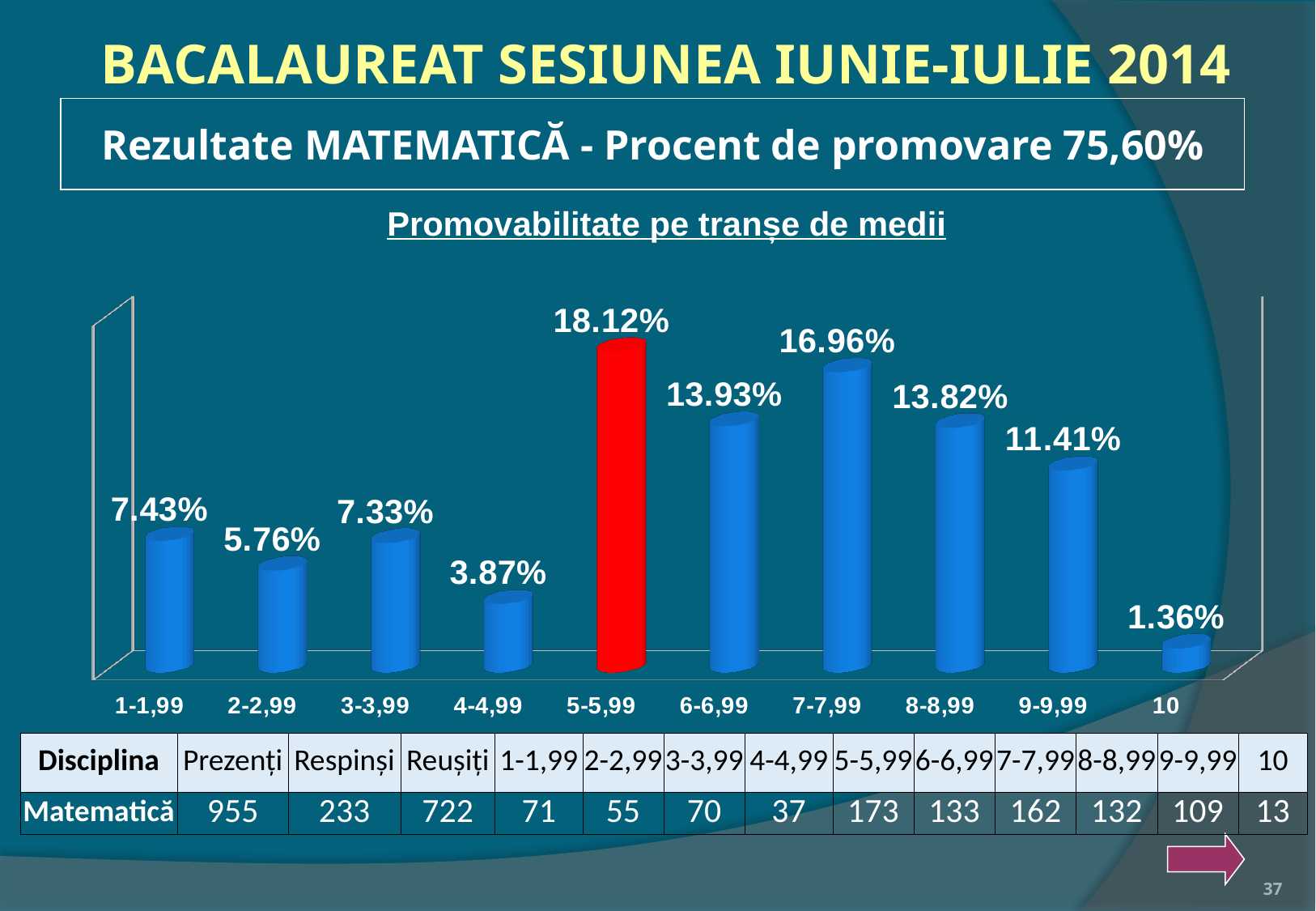
What is the difference between the values for 9-9,99 and 10? 10.05% What is the difference between the values for 5-5,99 and 7-7,99? 1.16% What is the value for the 5-5,99 category? 18.12% What is the value for the 10 category? 1.36% Which is larger, the value for 2-2,99 or the value for 9-9,99? 9-9,99 What is the value for the 7-7,99 category? 16.96% What is the value for the 4-4,99 category? 3.87% Which category has the lowest value? 10 How many categories are shown on the x axis of the chart? 10 What type of chart is shown on the slide? bar chart What is the title of the chart? Promovabilitate pe tranșe de medii Which category has the highest value? 5-5,99